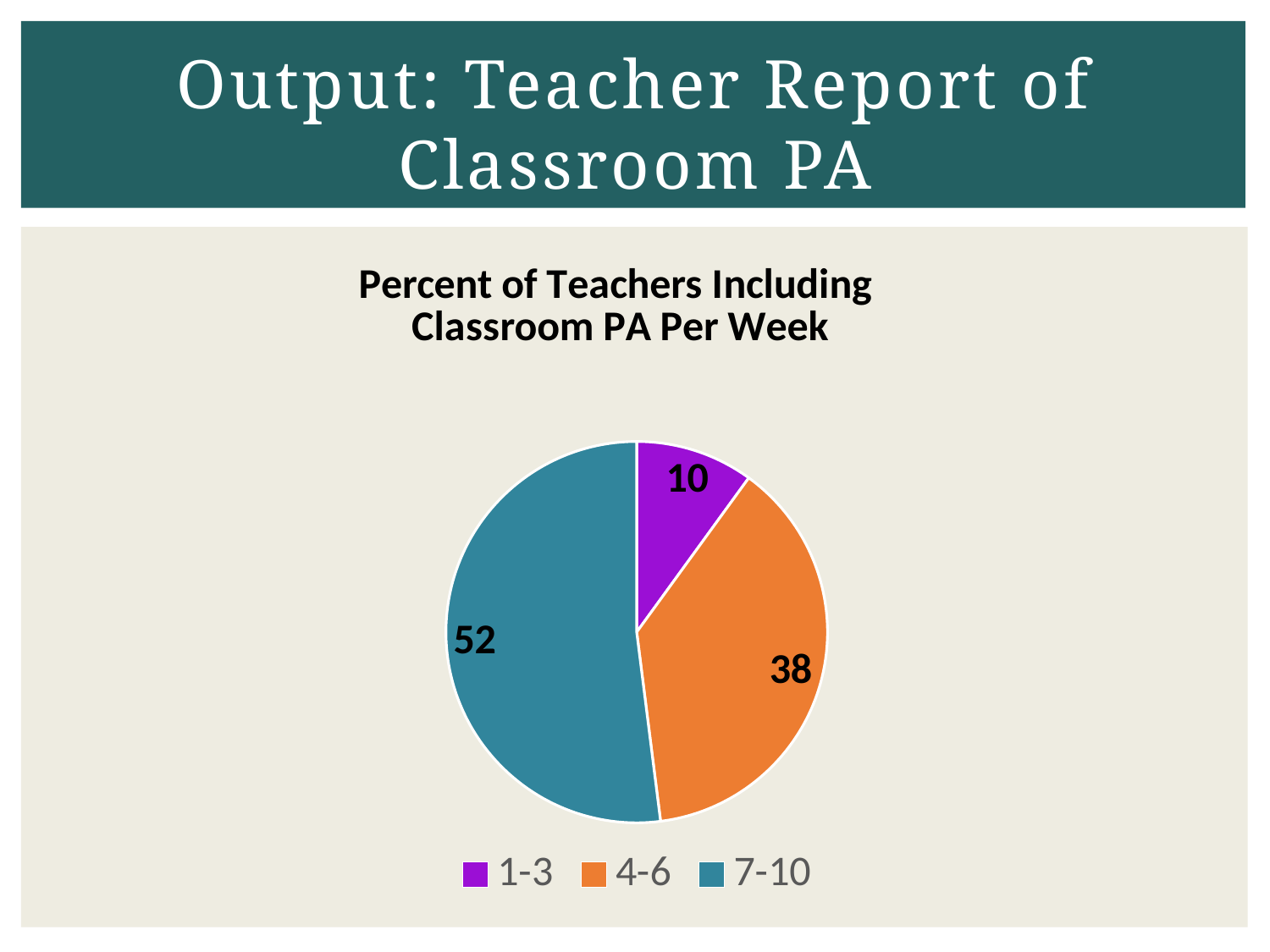
How many categories does the pie chart have? 3 Which is larger, the value for 4-6 or the value for 1-3? 4-6 What is the value for the 4-6 category? 38 What type of chart is shown on the slide? pie chart Which category has the largest slice? 7-10 What is the difference between the values for 7-10 and 4-6? 14 What is the title of the chart? Percent of Teachers Including Classroom PA Per Week What is the difference between the values for 4-6 and 1-3? 28 What is the value for the 7-10 category? 52 What is the value for the 1-3 category? 10 What colour is the slice for the 4-6 category? orange Which category has the smallest slice? 1-3